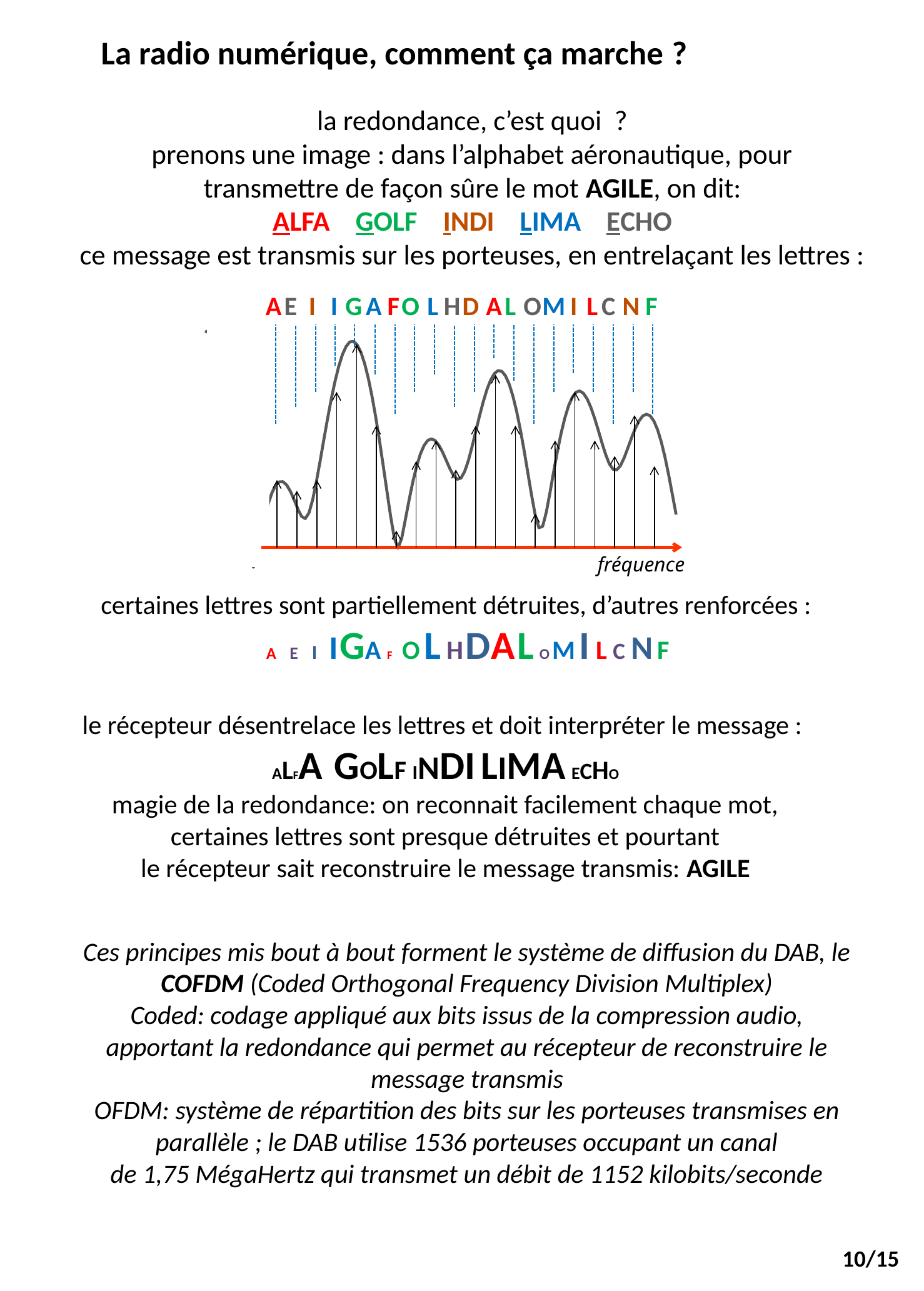
How many carriers (vertical arrows) are shown in the diagram? 20 Which letter sits above the carrier with the smallest amplitude in the diagram? F Which letter sits above the carrier with the greatest amplitude in the diagram? G What sequence of letters is written above the carriers in the diagram? A E I I G A F O L H D A L O M I L C N F Is the amplitude of the carrier under the letter G larger or smaller than that of the carrier under the first letter A? larger What is the label on the horizontal axis of the diagram? fréquence